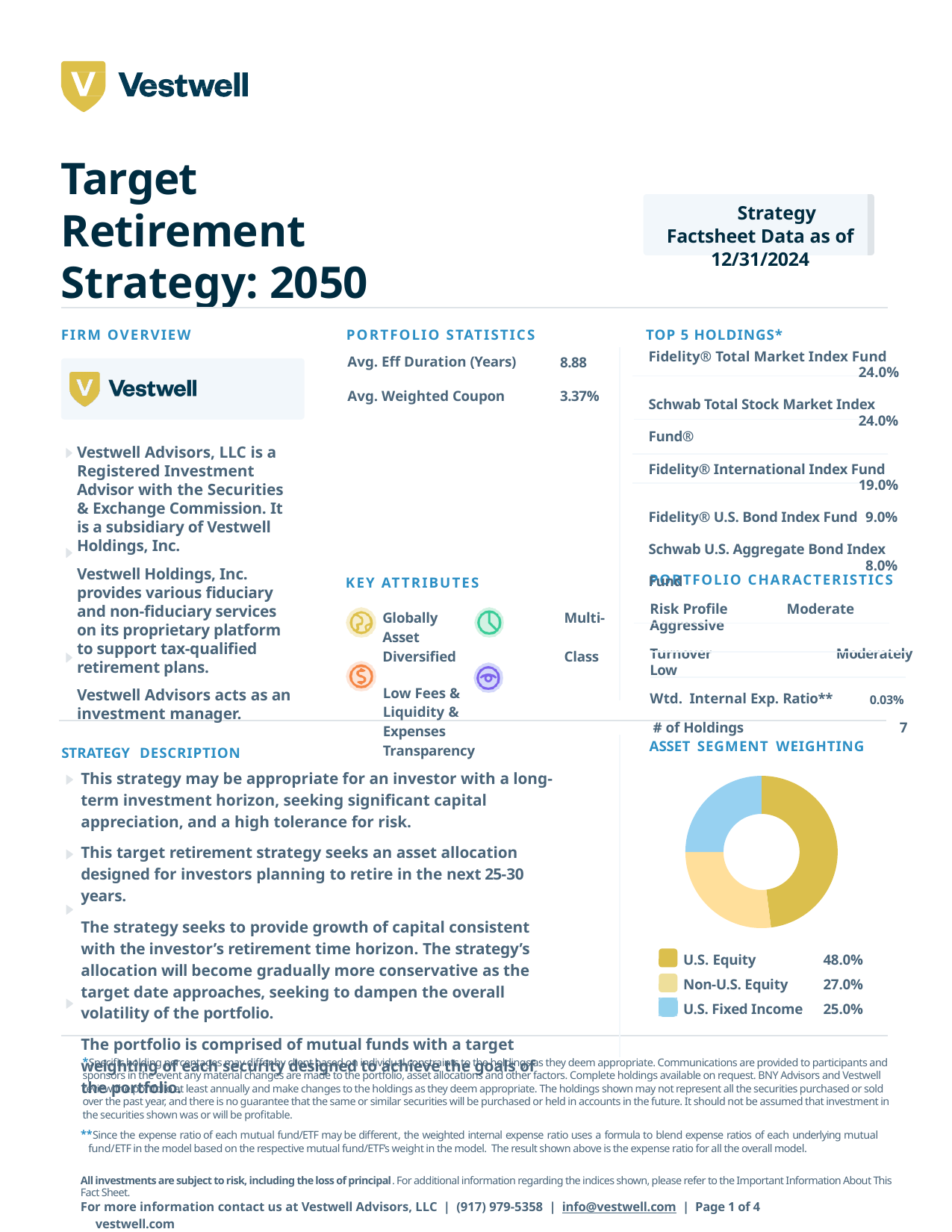
In the Asset Segment Weighting chart, what is the difference between U.S. Equity and Non-U.S. Equity? 21.0% In the Asset Segment Weighting chart, which is larger: U.S. Equity or U.S. Fixed Income? U.S. Equity In the Asset Segment Weighting chart, what is the value for U.S. Equity? 48.0% Which segment is the largest in the Asset Segment Weighting chart? U.S. Equity What colour represents U.S. Fixed Income in the Asset Segment Weighting chart? Light blue What is the combined share of Non-U.S. Equity and U.S. Fixed Income in the Asset Segment Weighting chart? 52.0% In the Asset Segment Weighting chart, what is the difference between Non-U.S. Equity and U.S. Fixed Income? 2.0% How many segments does the Asset Segment Weighting chart have? 3 In the Asset Segment Weighting chart, what is the value for U.S. Fixed Income? 25.0% What kind of chart is shown under Asset Segment Weighting? Pie chart (donut) In the Asset Segment Weighting chart, what is the value for Non-U.S. Equity? 27.0% Which segment is the smallest in the Asset Segment Weighting chart? U.S. Fixed Income